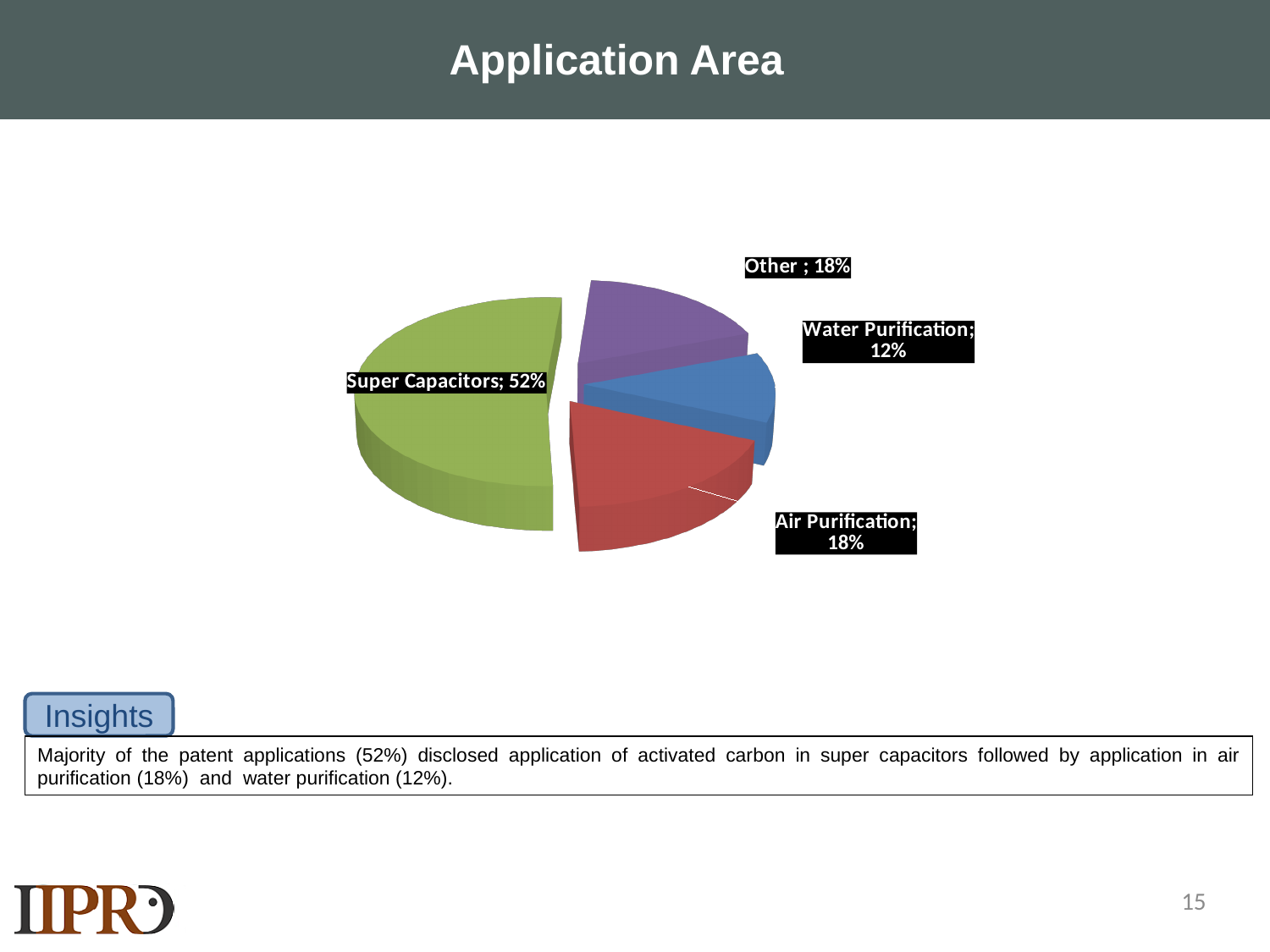
What share of the pie does Other represent? 18% What colour is the Super Capacitors slice? Green What is the difference in percentage points between Air Purification and Water Purification? 6 Which application area has the largest share of the pie? Super Capacitors Which is larger, the share for Water Purification or the share for Other? Other How many slices does the pie chart have? 4 What is the difference in percentage points between Super Capacitors and Air Purification? 34 What share of the pie does Water Purification represent? 12% Which application area has the smallest share of the pie? Water Purification What kind of chart is shown on the slide? Pie chart What share of the pie does Super Capacitors represent? 52% What share of the pie does Air Purification represent? 18%